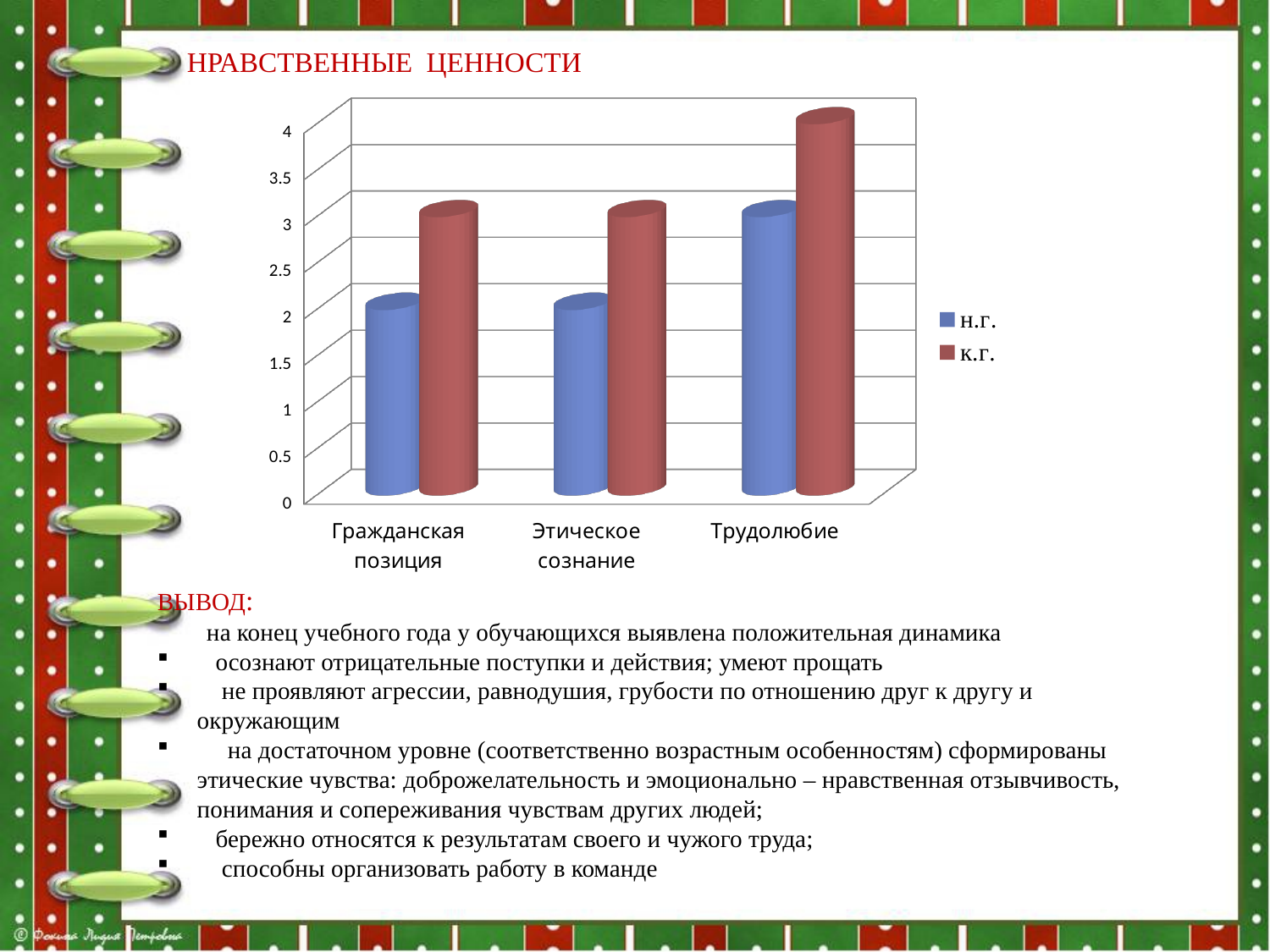
How many categories are shown on the x axis of the chart? 3 Is the к.г. value for Этическое сознание greater or less than 2.5? greater What kind of chart is shown on the slide? bar chart Is the к.г. value for Трудолюбие greater or less than 3.5? greater How many series does the chart legend list? 2 For Трудолюбие, which series has the larger value, н.г. or к.г.? к.г. What are the two series named in the chart legend? н.г. and к.г. What is the title shown above the chart? НРАВСТВЕННЫЕ ЦЕННОСТИ Which category has the highest value for the н.г. series? Трудолюбие For Гражданская позиция, which series has the larger value, н.г. or к.г.? к.г. Which category has the highest value for the к.г. series? Трудолюбие Is the н.г. value for Гражданская позиция greater or less than 2.5? less